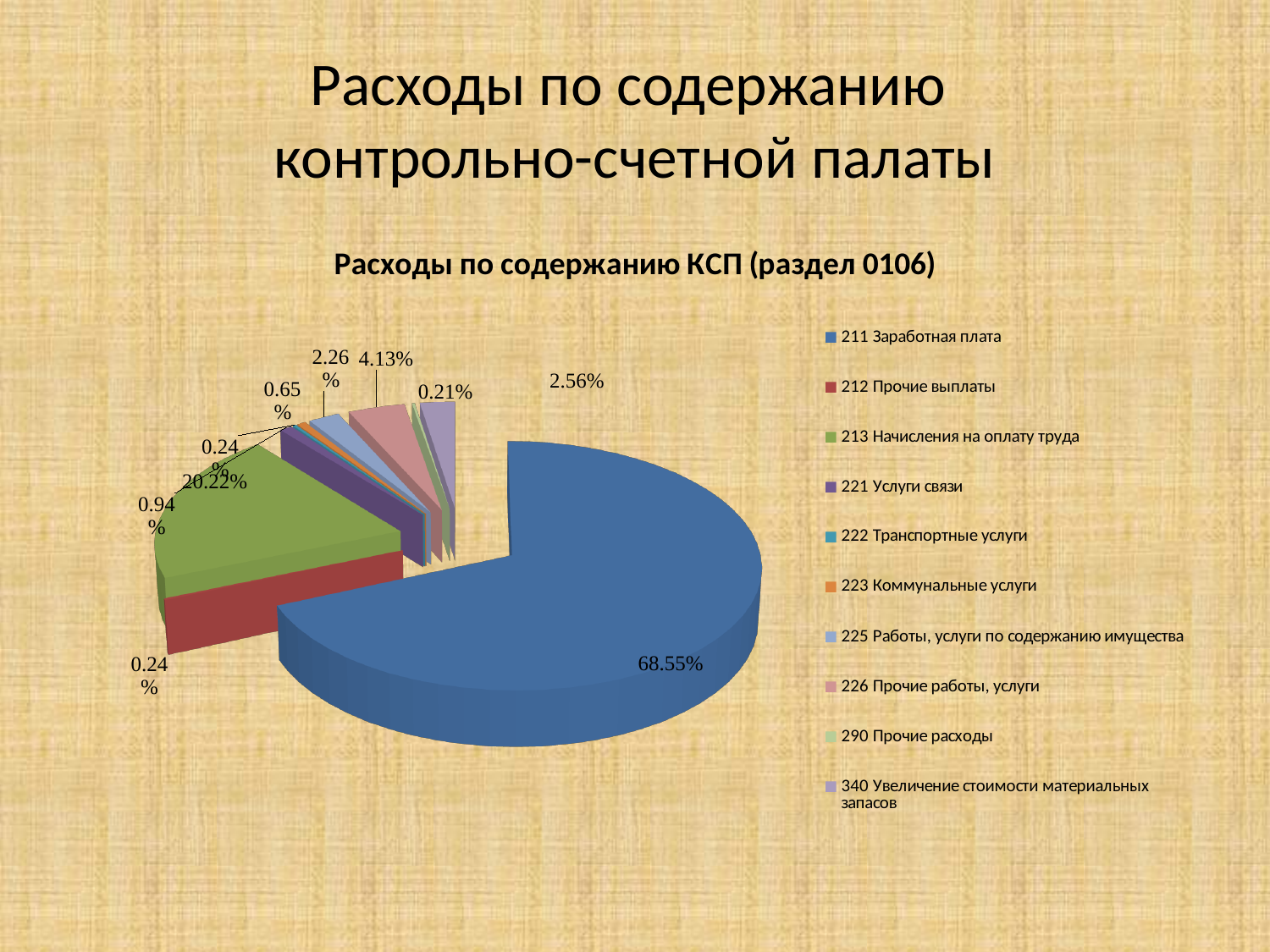
What share of the pie is labelled for 213 Начисления на оплату труда? 20.22% What is the title of the chart? Расходы по содержанию КСП (раздел 0106) What share of the pie is labelled for 340 Увеличение стоимости материальных запасов? 2.56% Which category has the largest share of the pie? 211 Заработная плата What share of the pie is labelled for 211 Заработная плата? 68.55% What is the smallest percentage label shown on the pie chart? 0.21% Which is larger: the share of 213 Начисления на оплату труда or the share of 226 Прочие работы, услуги? 213 Начисления на оплату труда How many entries does the chart legend list? 10 What kind of chart is shown on the slide? pie chart How many slices does the pie chart have? 10 What is the difference in percentage points between the shares of 211 Заработная плата and 213 Начисления на оплату труда? 48.33%